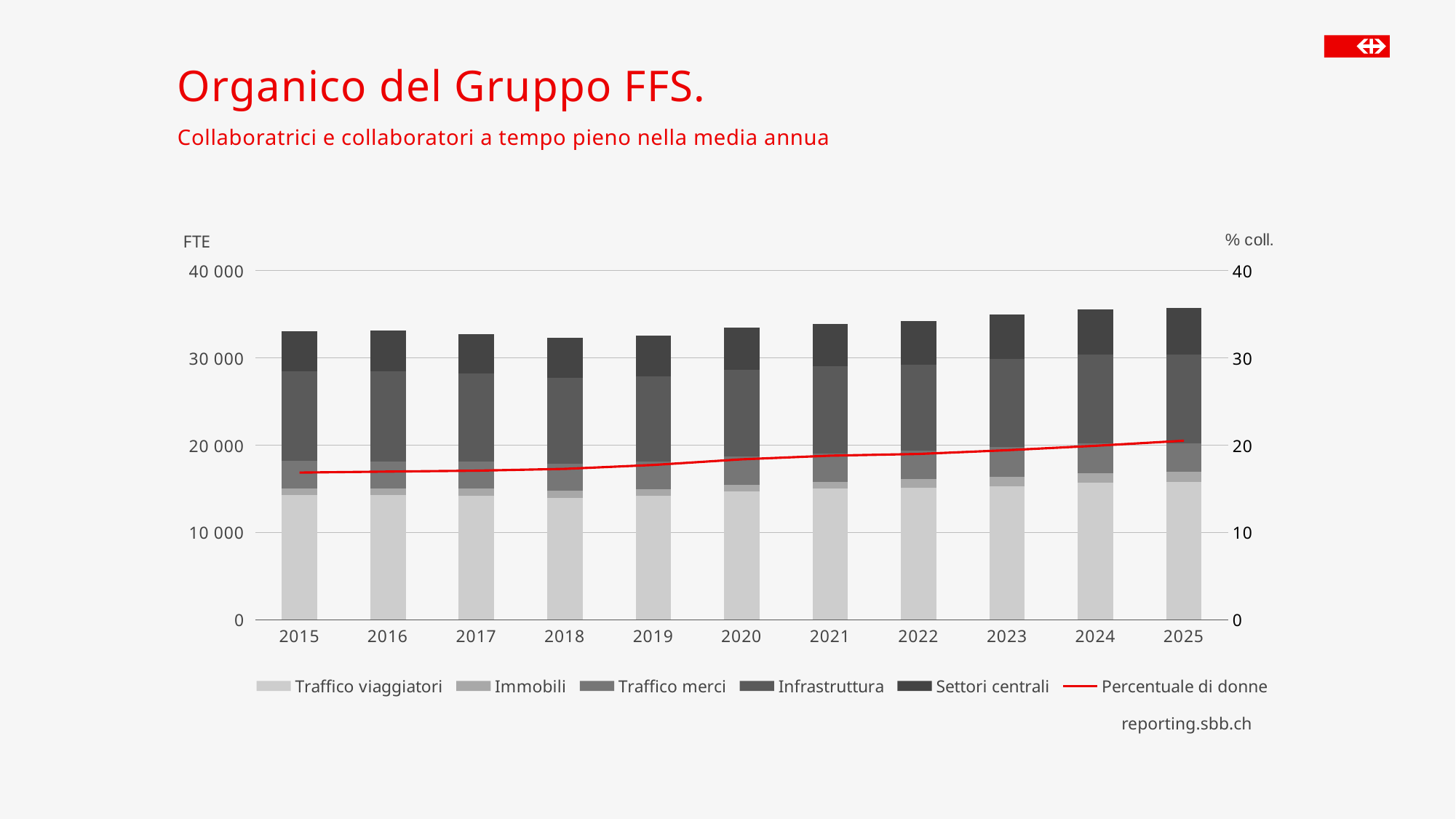
How many series does the legend list? 6 Which series is drawn as a red line rather than as bars? Percentuale di donne What kind of chart is shown on the slide? Stacked bar chart with a line In 2025, which segment is larger, Traffico viaggiatori or Settori centrali? Traffico viaggiatori Is the Percentuale di donne value for 2015 greater or less than 20? less How many years are shown on the x axis of the chart? 11 Does the Percentuale di donne line rise or fall from 2015 to 2025? rise Is the total FTE bar for 2018 greater or less than 35 000? less Which total FTE bar is larger, 2015 or 2025? 2025 What is the title of the slide? Organico del Gruppo FFS. Is the total FTE bar for 2015 greater or less than 30 000? greater